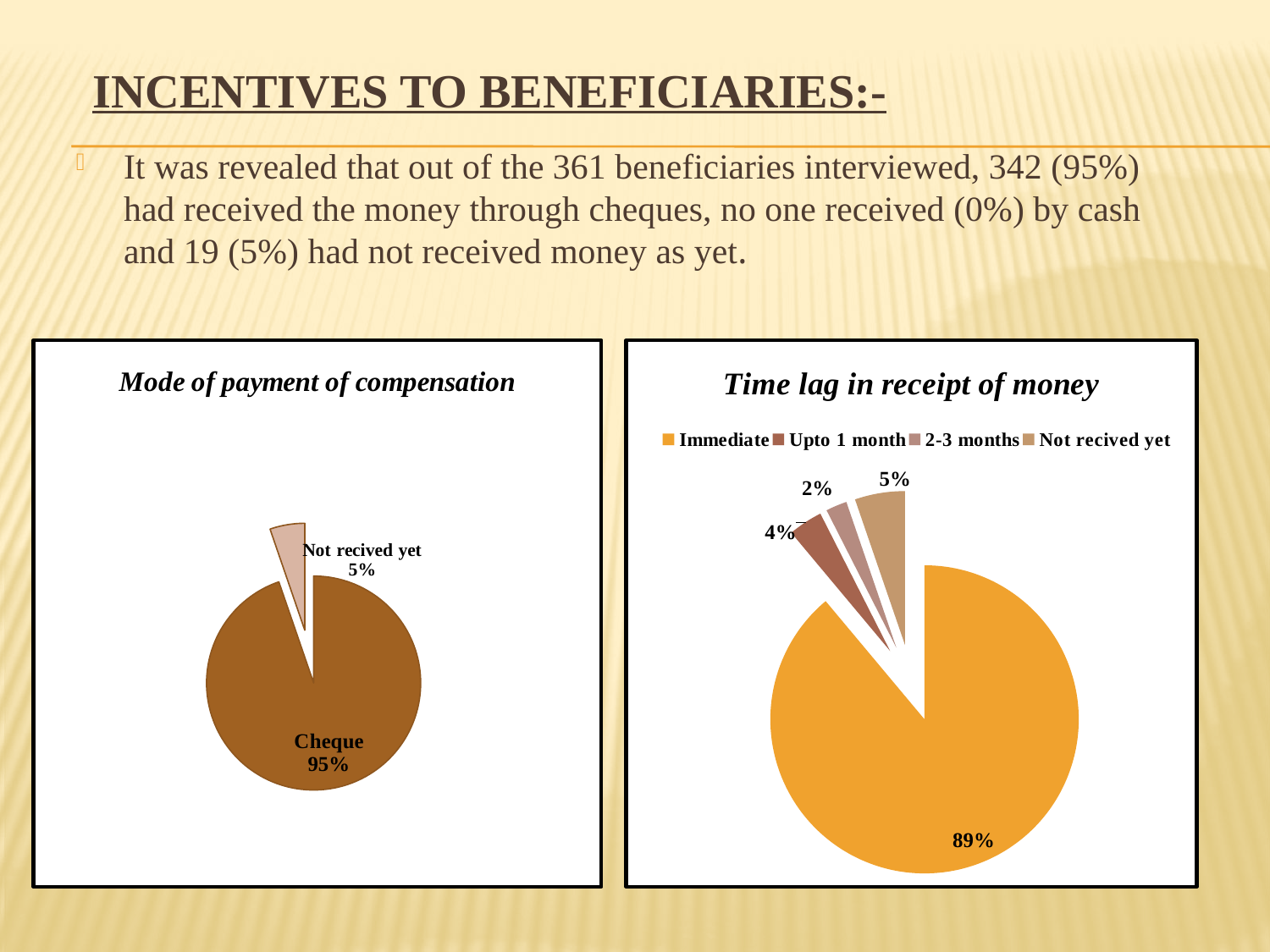
In the 'Time lag in receipt of money' chart, what share is shown for 2-3 months? 2% In the 'Mode of payment of compensation' chart, what is the difference between the Cheque share and the Not recived yet share? 90% In the 'Time lag in receipt of money' chart, which is larger: the share for Upto 1 month or the share for Not recived yet? Not recived yet In the 'Time lag in receipt of money' chart, what share is shown for Upto 1 month? 4% In the 'Mode of payment of compensation' chart, what share is labelled 'Not recived yet'? 5% In the 'Time lag in receipt of money' chart, which category has the smallest share? 2-3 months What kind of chart is 'Mode of payment of compensation'? Pie chart How many slices does the 'Mode of payment of compensation' pie chart have? 2 In the 'Mode of payment of compensation' chart, what share of beneficiaries received payment by cheque? 95% In the 'Time lag in receipt of money' chart, which category has the largest share? Immediate In the 'Time lag in receipt of money' chart, what share is labelled for Immediate? 89% How many categories does the legend of the 'Time lag in receipt of money' chart list? 4